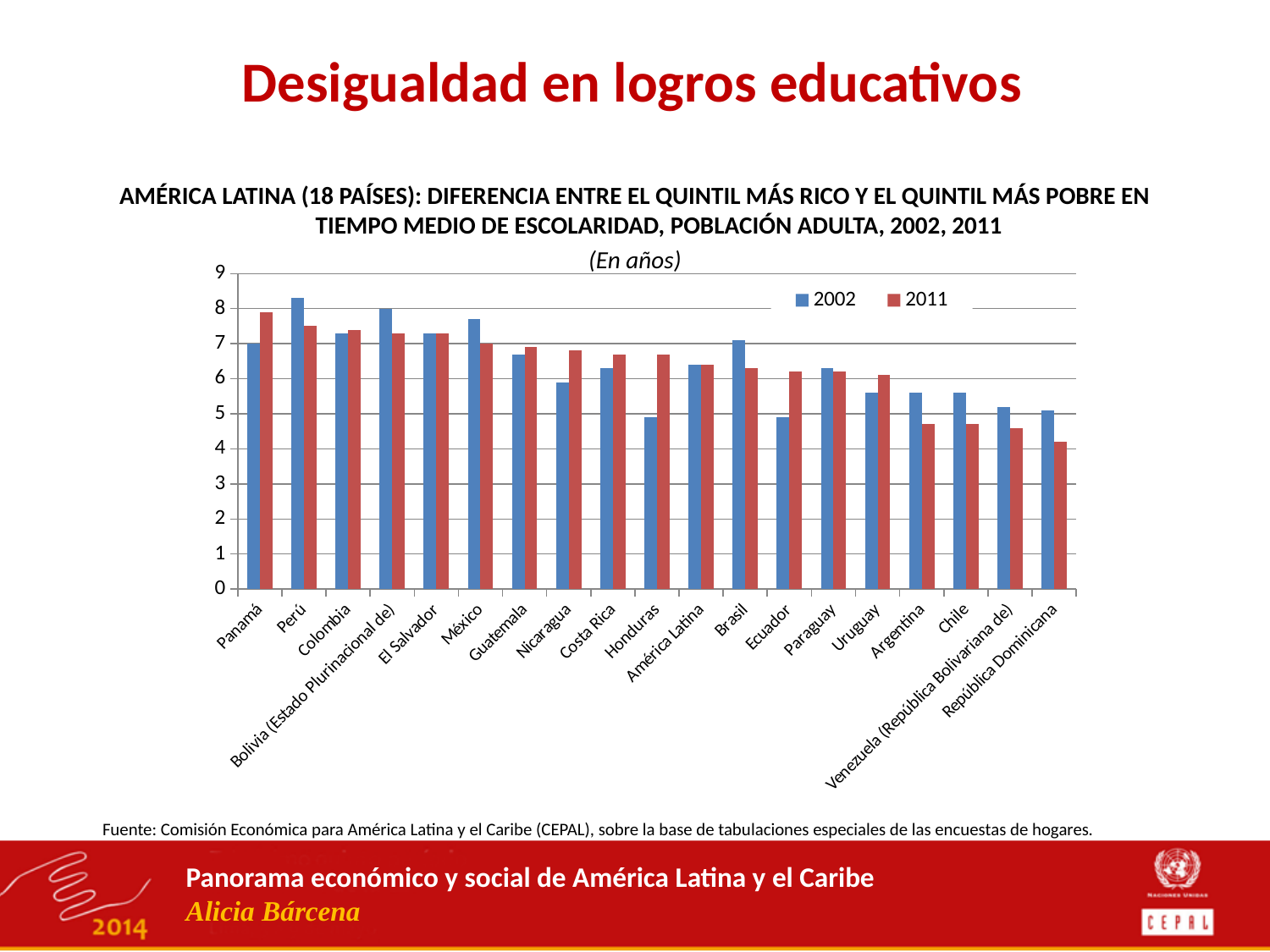
Which two years are shown in the legend? 2002 and 2011 For Honduras, which is larger: the 2002 value or the 2011 value? 2011 What kind of chart is shown on the slide? bar chart Which category has the highest value for 2011? Panamá Is the 2002 value for Perú greater or less than 8? greater Which category has the highest value for 2002? Perú How many categories are shown along the x axis? 19 Which category has the lowest value for 2011? República Dominicana For Perú, which is larger: the 2002 value or the 2011 value? 2002 How many series does the legend list? 2 Is the 2011 value for Chile greater or less than 5? less